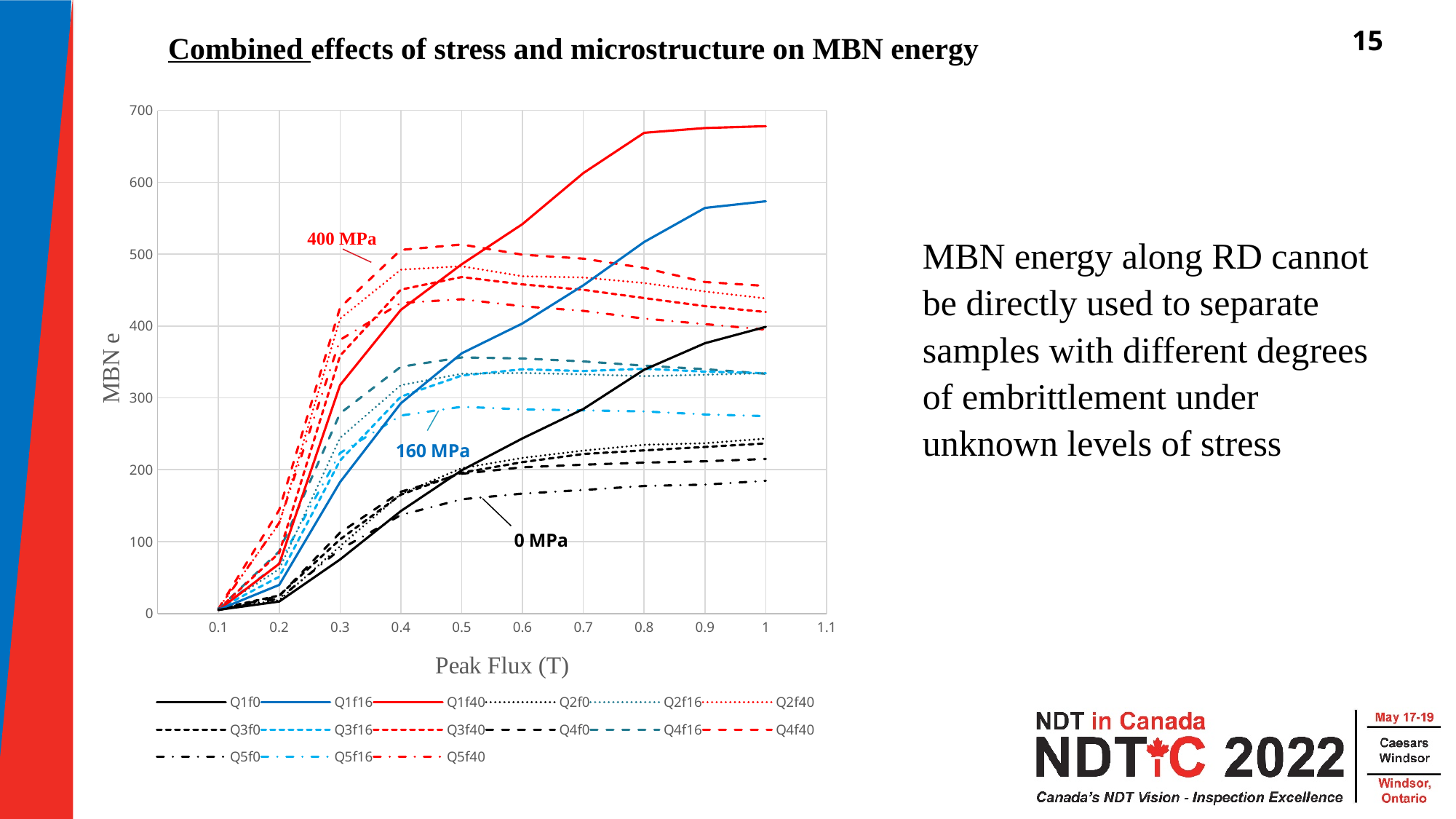
What is the label of the x axis of the chart? Peak Flux (T) Is the value of the Q1f16 series at a peak flux of 1 greater or less than 500? greater Is the value of the Q5f0 series at a peak flux of 1 greater or less than 200? less Does the Q1f0 series rise or fall as peak flux increases from 0.1 to 1? rise Is the value of the Q1f40 series at a peak flux of 1 greater or less than 600? greater At a peak flux of 1, which series has the larger value, Q1f40 or Q1f0? Q1f40 At a peak flux of 0.5, which series has the larger value, Q1f16 or Q1f0? Q1f16 How many series does the chart legend list? 15 What kind of chart is shown on the slide? line chart What stress level is annotated next to the red curves in the chart? 400 MPa Which series reaches the highest MBN energy value on the chart? Q1f40